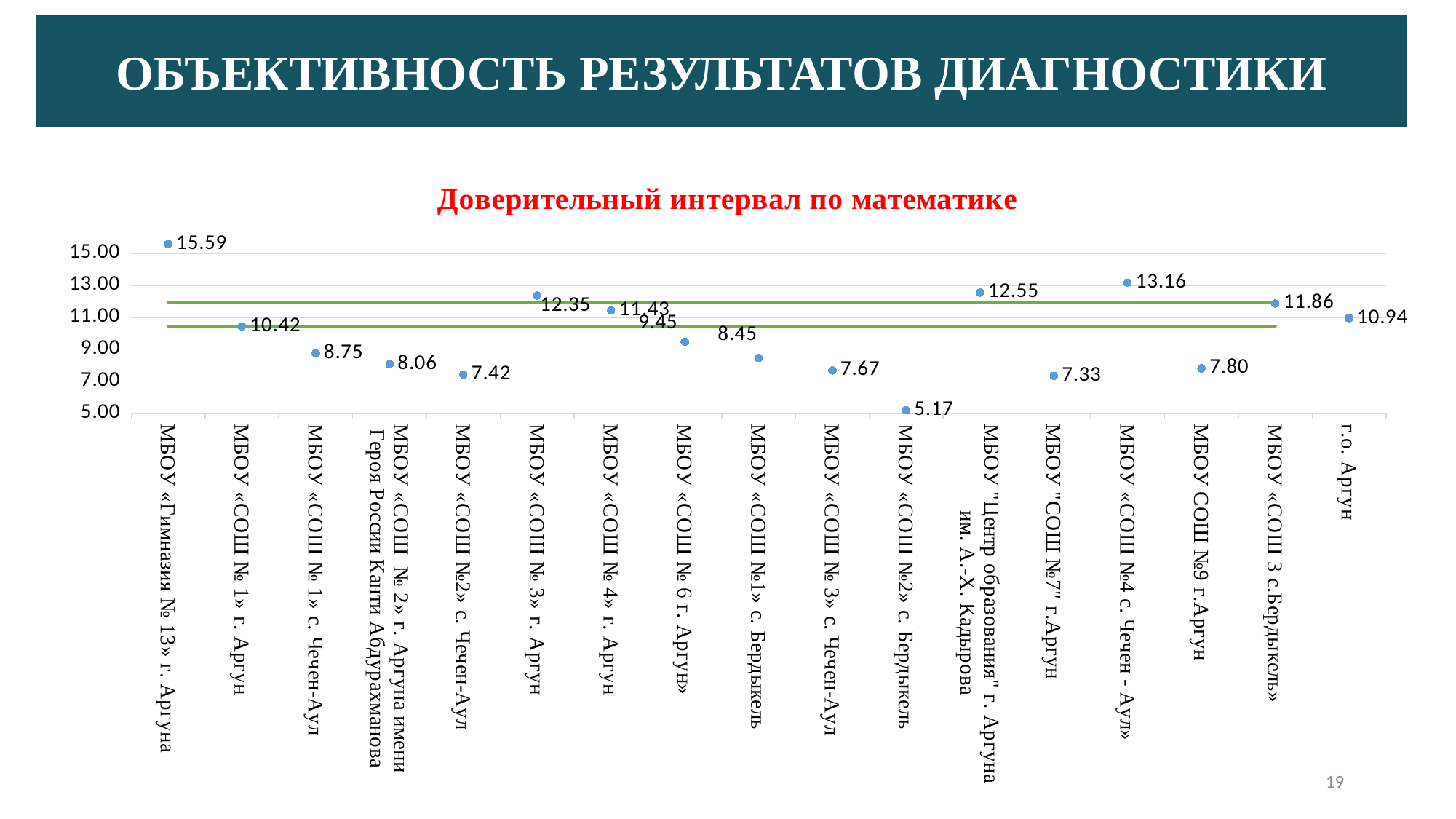
Which is larger: the value for МБОУ «СОШ № 1» г. Аргун or the value for МБОУ «СОШ № 6 г. Аргун»? МБОУ «СОШ № 1» г. Аргун What is the title of the chart? Доверительный интервал по математике What is the value for МБОУ «СОШ №2» с. Бердыкель? 5.17 What is the value for МБОУ "Центр образования" г. Аргуна им. А.-Х. Кадырова? 12.55 Which category has the lowest value? МБОУ «СОШ №2» с. Бердыкель What is the difference between the values for МБОУ «СОШ №4 с. Чечен-Аул» and МБОУ «СОШ № 3» г. Аргун? 0.81 What is the value for г.о. Аргун? 10.94 Is the value for МБОУ "СОШ №7" г.Аргун greater or less than 9.00? less Which category has the highest value? МБОУ «Гимназия № 13» г. Аргуна What kind of chart is shown on the slide? scatter chart What is the value for МБОУ «Гимназия № 13» г. Аргуна? 15.59 How many categories are plotted on the chart? 17